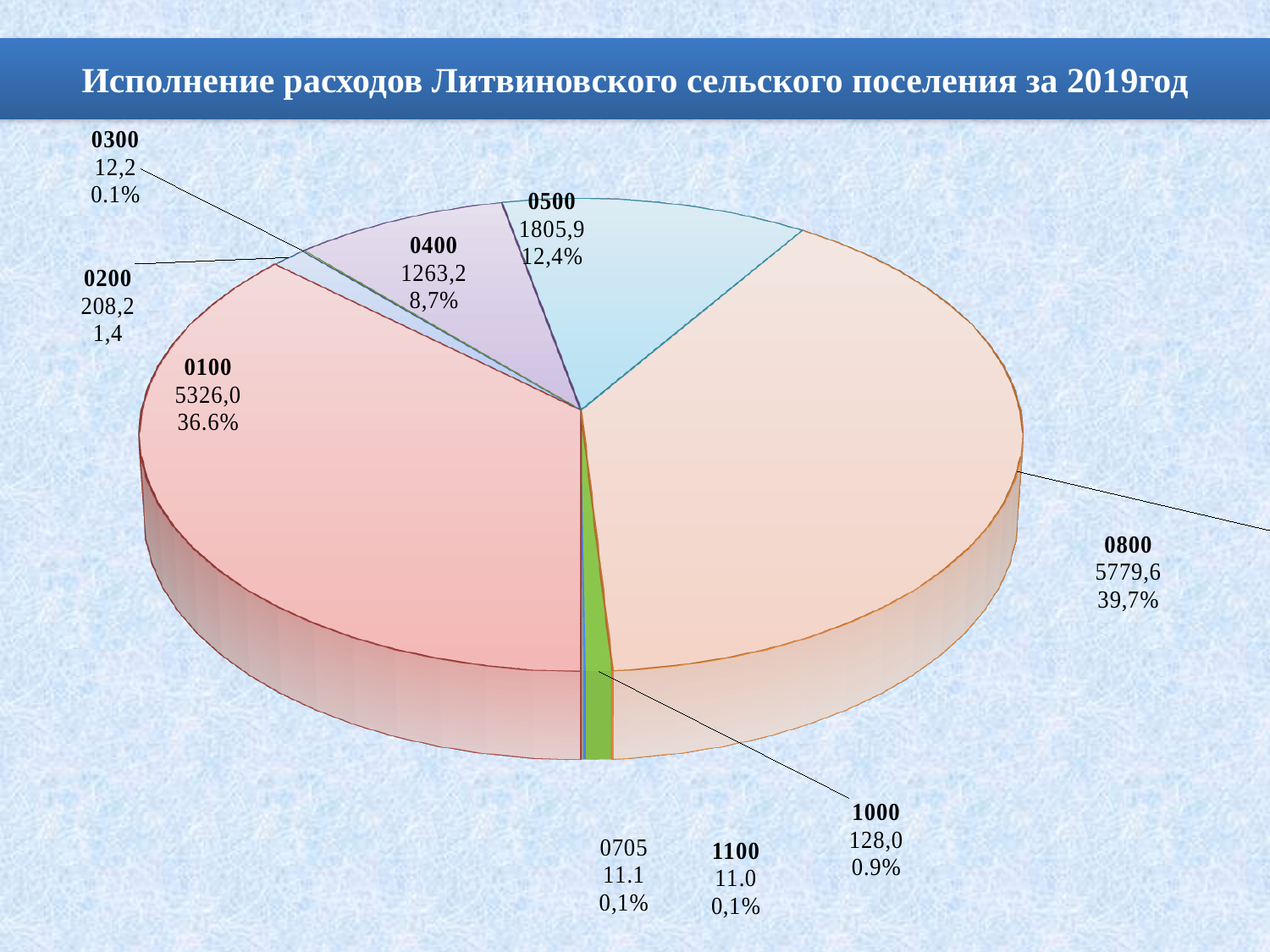
Which category has the largest slice of the pie? 0800 What is the value shown for category 0100? 5326,0 What is the value shown for category 0400? 1263,2 What kind of chart is shown on the slide? pie chart What is the title of the chart? Исполнение расходов Литвиновского сельского поселения за 2019год What is the value shown for category 0800? 5779,6 How many categories (slices) does the pie chart have? 9 What share of the pie does category 0100 represent? 36.6% Which is larger, the value for 0800 or the value for 0100? 0800 What is the value shown for category 0500? 1805,9 What is the value shown for category 1000? 128,0 What share of the pie does category 0500 represent? 12,4%